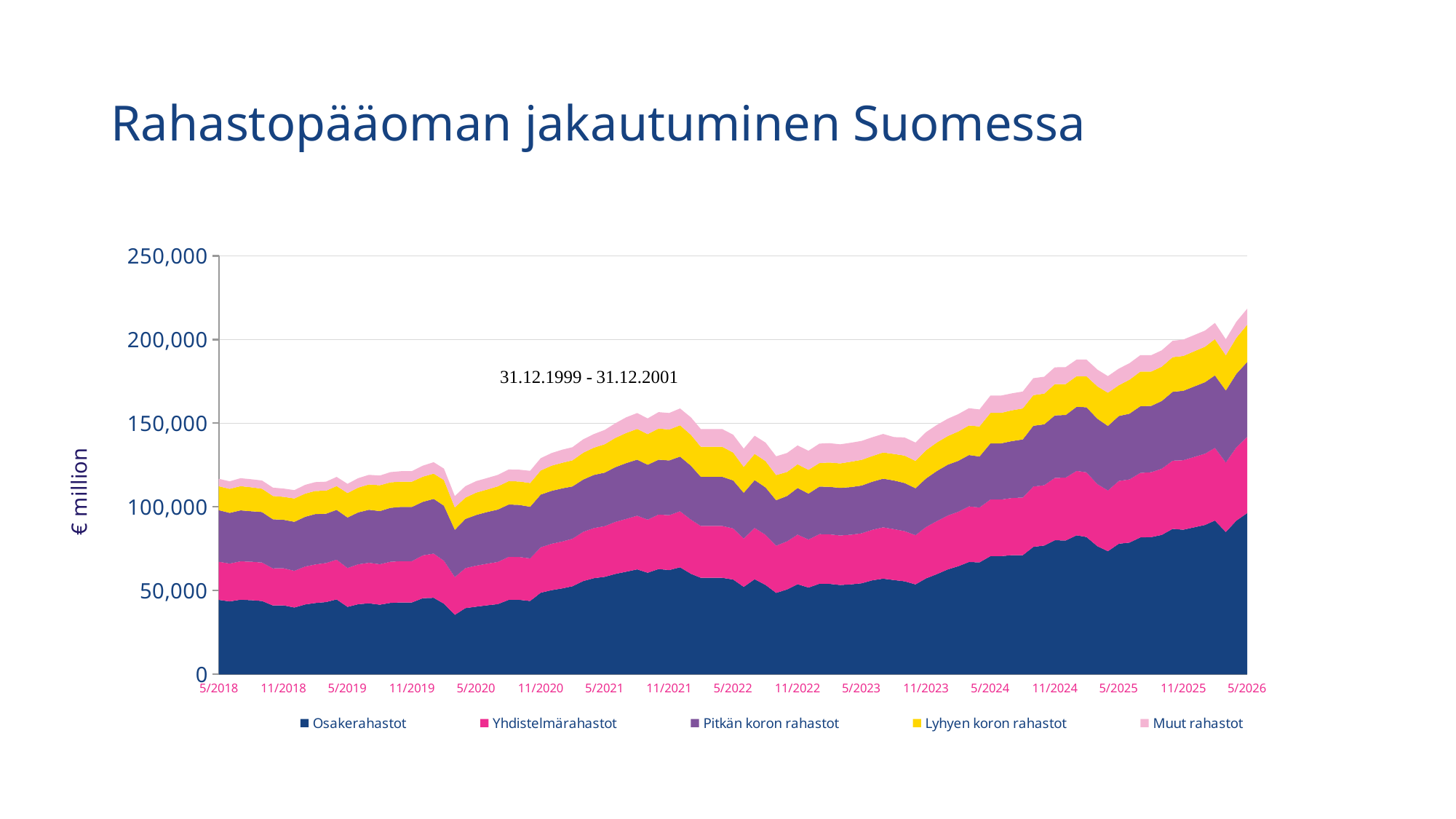
How many series does the legend list? 5 Is the total fund capital at 5/2018 greater or less than 150,000? less Is the value for Osakerahastot at 5/2018 greater or less than 50,000? less At which x-axis date is the total fund capital highest? 5/2026 Which series has the larger value at 5/2026, Osakerahastot or Muut rahastot? Osakerahastot How many date labels are shown on the x axis? 17 What is the label on the vertical axis? € million Does the total fund capital rise or fall overall from 5/2018 to 5/2026? rise Is the total fund capital at 5/2023 greater or less than 150,000? less What kind of chart is shown on the slide? Stacked area chart What is the title of the chart? Rahastopääoman jakautuminen Suomessa